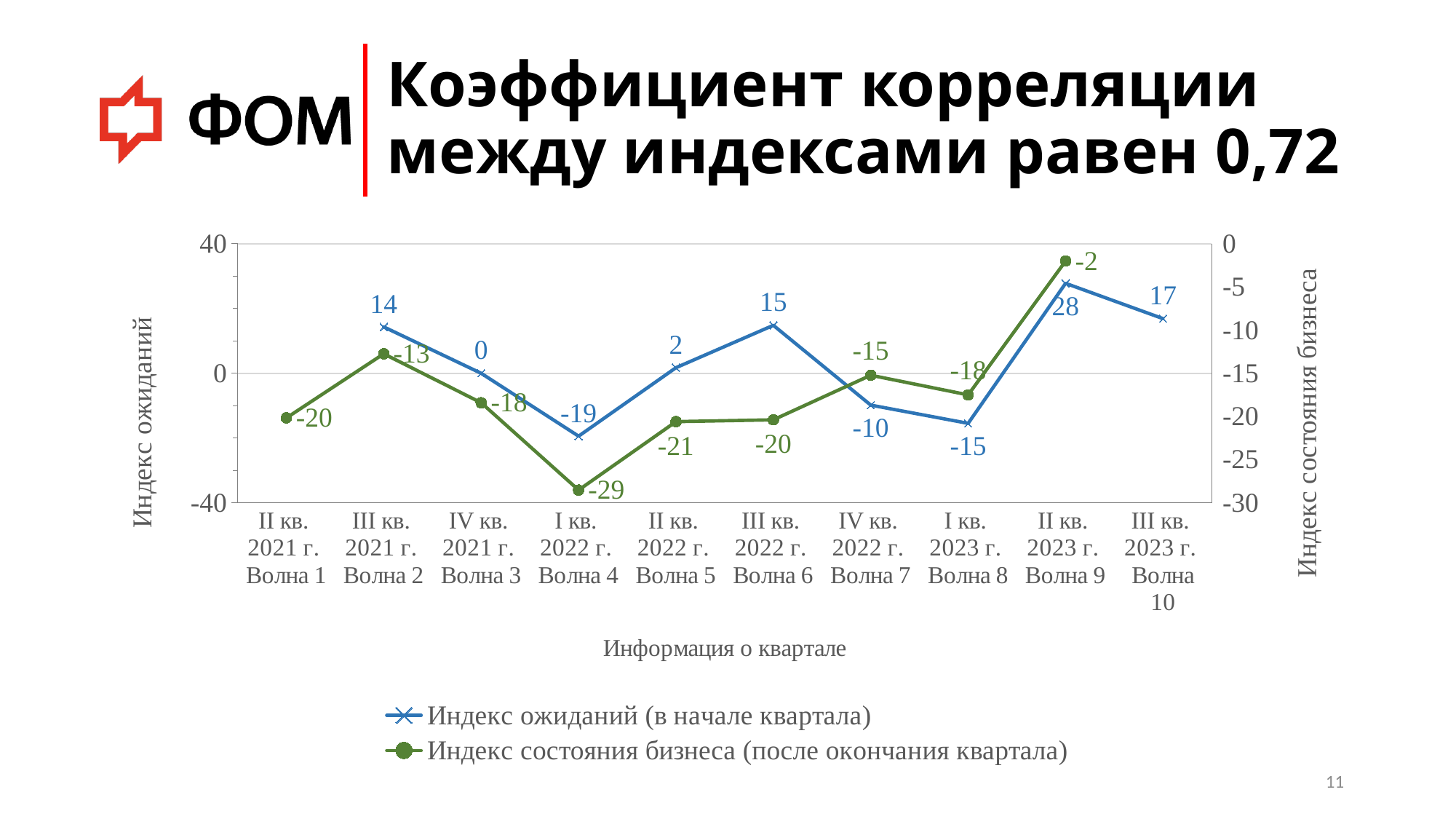
How many series does the legend list? 2 What is the value of the Индекс состояния бизнеса series for Волна 4 (I кв. 2022 г.)? -29 What kind of chart is shown on the slide? Line chart What is the value of the Индекс ожиданий series for Волна 9 (II кв. 2023 г.)? 28 In which wave does the Индекс состояния бизнеса series reach its highest value? Волна 9 What is the value of the Индекс состояния бизнеса series for Волна 1 (II кв. 2021 г.)? -20 Which is larger: the Индекс ожиданий value for Волна 6 or for Волна 2? Волна 6 What is the difference between the Индекс ожиданий values for Волна 9 and Волна 10? 11 What is the value of the Индекс ожиданий series for Волна 10 (III кв. 2023 г.)? 17 In which wave does the Индекс состояния бизнеса series reach its lowest value? Волна 4 How many waves (categories) are shown on the x axis? 10 In which wave does the Индекс ожиданий series reach its highest value? Волна 9